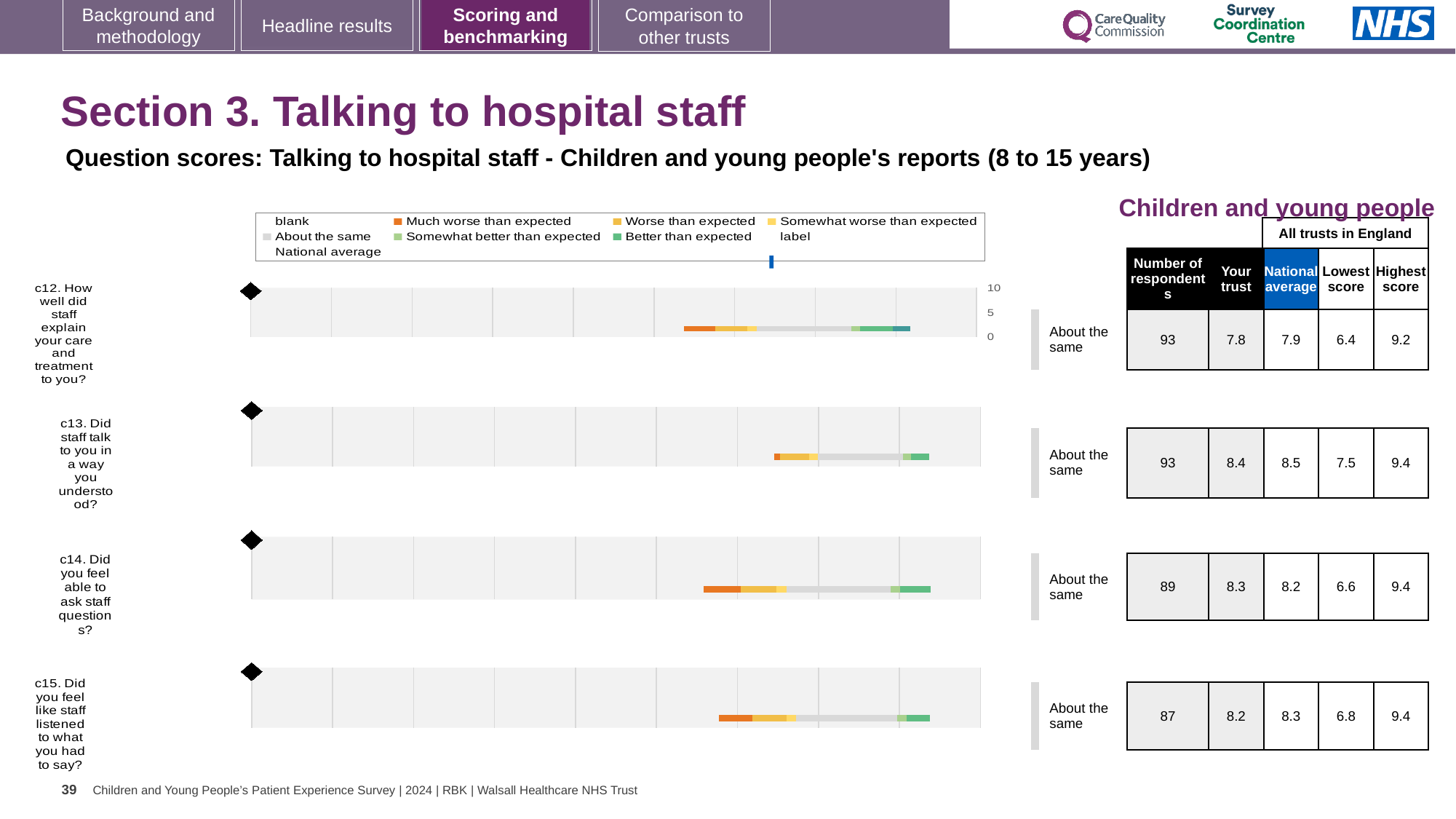
For question c15 (Did you feel like staff listened to what you had to say?), what is the highest score among all trusts in England? 9.4 How many question charts are shown on this slide? 4 How many respondents answered question c14 (Did you feel able to ask staff questions?)? 89 Which question has the lowest 'Your trust' score on this slide? c12 For question c14, which is larger: the 'Your trust' score or the national average? Your trust What benchmark category is shown next to the chart for question c13? About the same For question c12 (How well did staff explain your care and treatment to you?), what is the 'Your trust' score? 7.8 For question c12, what is the difference between the highest score and the lowest score among all trusts in England? 2.8 For question c15, what is the difference between the national average and the 'Your trust' score? 0.1 For question c13 (Did staff talk to you in a way you understood?), what is the national average score? 8.5 What kind of chart is used to show each question's score? Bar chart Which question has the fewest respondents? c15